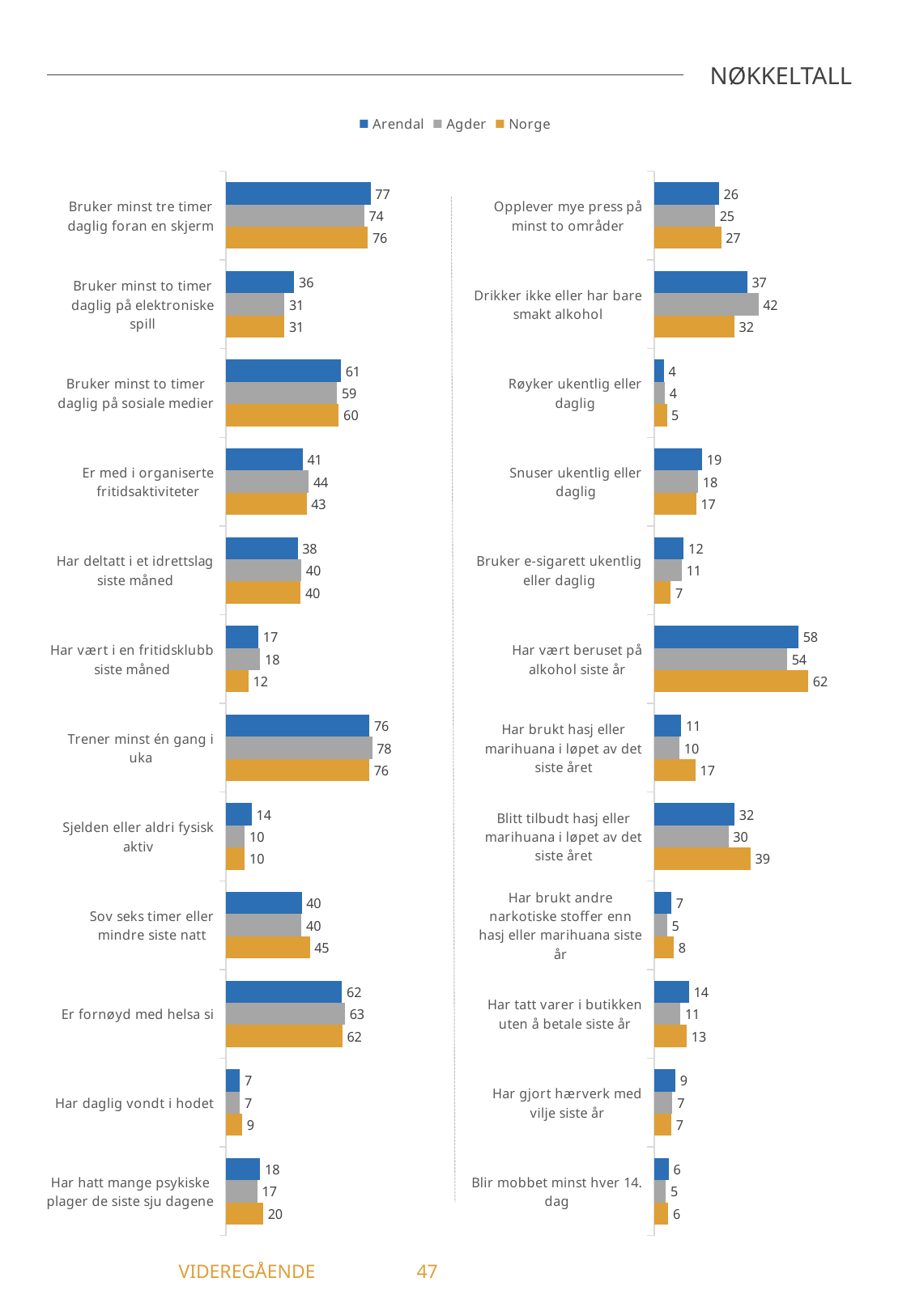
In the right chart, what is the difference between the Norge and Agder values for "Blitt tilbudt hasj eller marihuana i løpet av det siste året"? 9 In the right chart, for "Har brukt hasj eller marihuana i løpet av det siste året", which is larger: the Arendal value or the Norge value? Norge In the right chart, what is the Norge value for "Har vært beruset på alkohol siste år"? 62 In the left chart, what is the Arendal value for "Bruker minst tre timer daglig foran en skjerm"? 77 In the right chart, what is the Agder value for "Drikker ikke eller har bare smakt alkohol"? 42 How many categories are shown in the left chart? 12 In the left chart, what is the difference between the Norge and Arendal values for "Sov seks timer eller mindre siste natt"? 5 What type of chart is used on this slide? Bar chart In the left chart, for "Sjelden eller aldri fysisk aktiv", which is larger: the Arendal value or the Norge value? Arendal How many series does the legend list? 3 In the left chart, which category has the highest Arendal value? Bruker minst tre timer daglig foran en skjerm In the right chart, which category has the lowest Norge value? Røyker ukentlig eller daglig